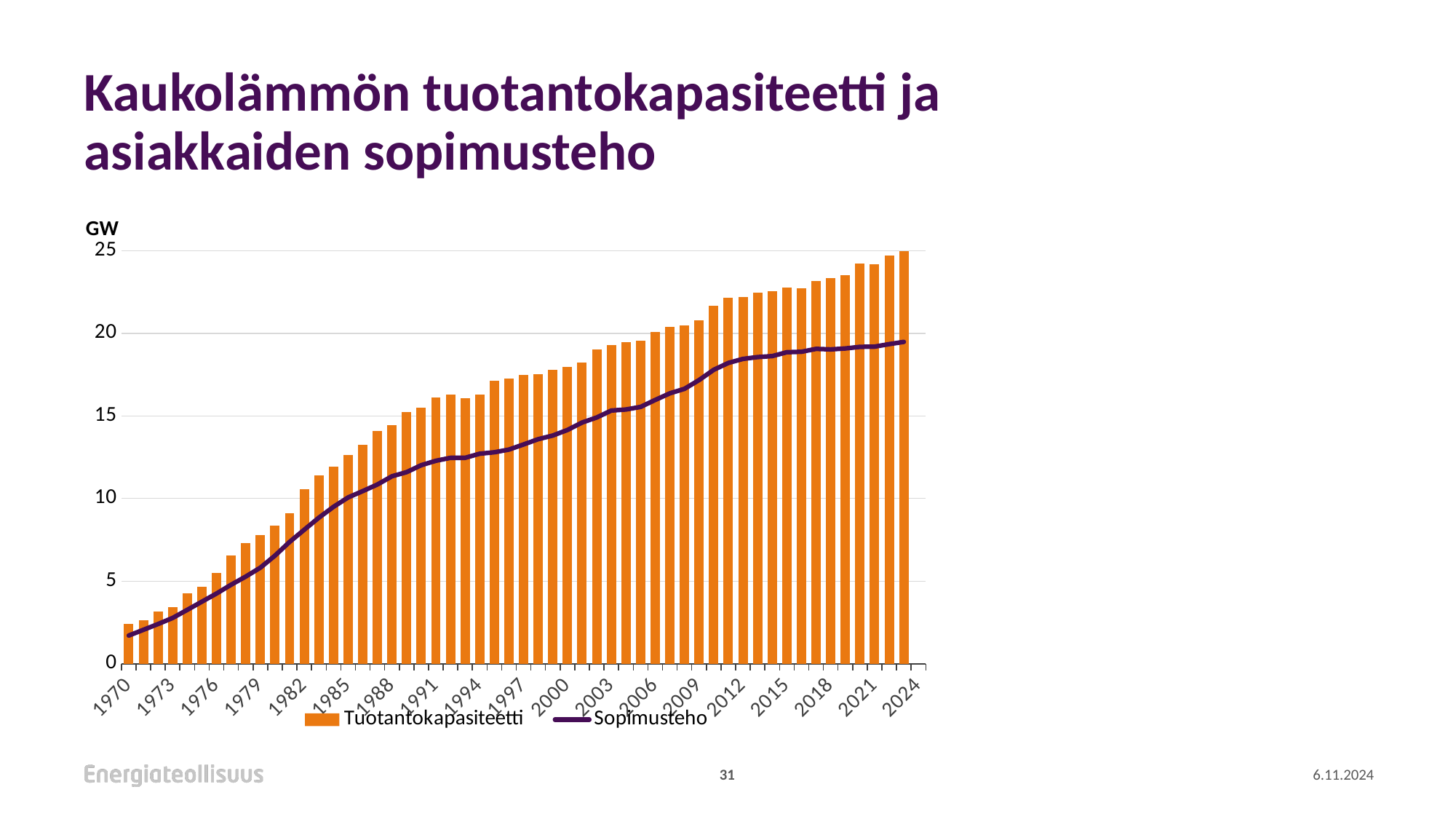
Which year has the highest Tuotantokapasiteetti bar? 2023 Is the Sopimusteho value for 1991 greater or less than 10? greater How many series does the legend list? 2 What kind of chart is shown on the slide? A bar chart combined with a line chart Do the Sopimusteho values generally rise or fall from 1970 to 2024? Rise What unit is shown on the vertical axis of the chart? GW Is the Tuotantokapasiteetti value for 1985 greater or less than 10? greater Which year has the lowest Tuotantokapasiteetti bar? 1970 Is the Tuotantokapasiteetti value for 1970 greater or less than 5? less